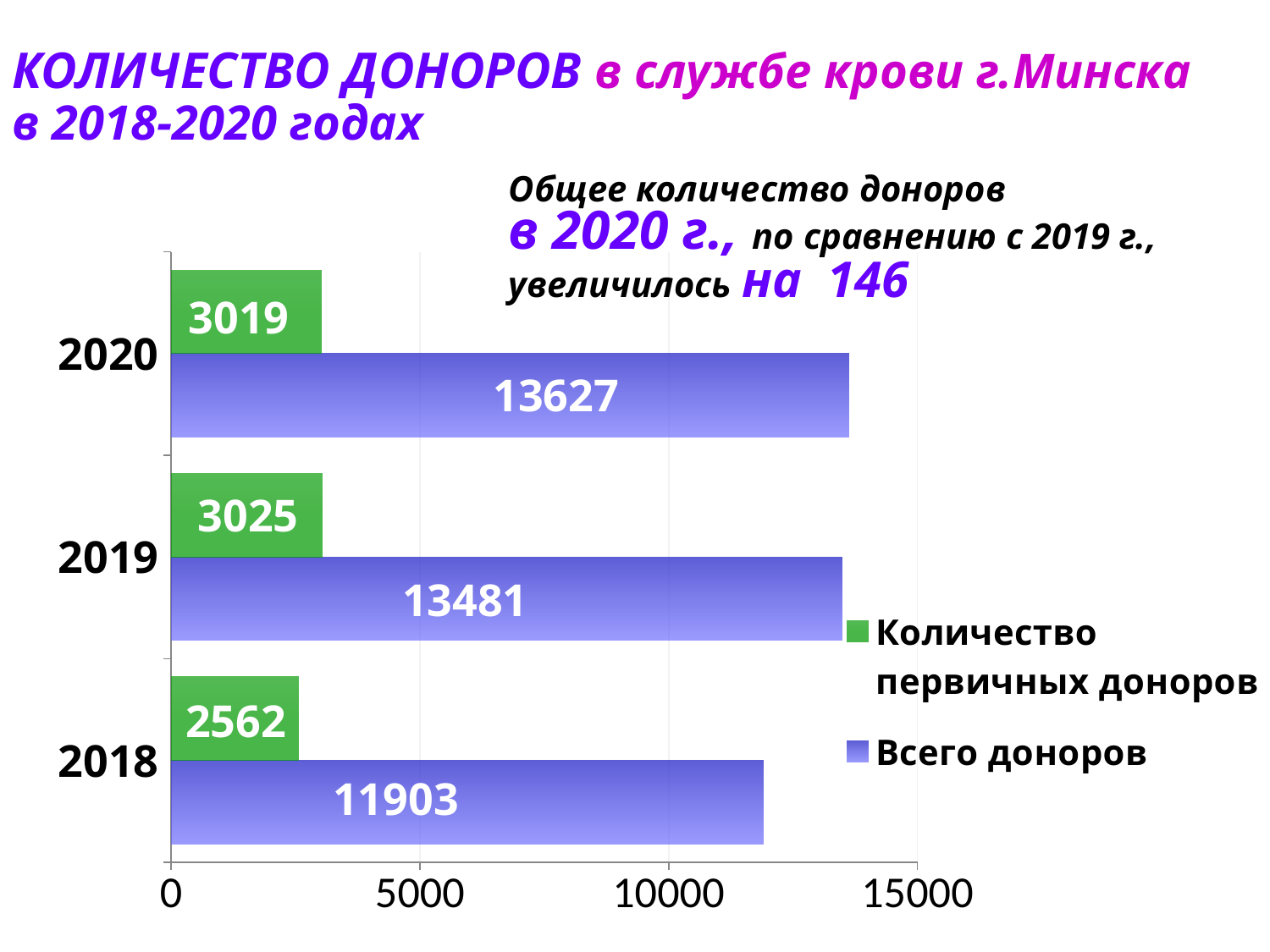
What is the difference between 'Всего доноров' in 2020 and in 2019? 146 Which year has the highest value for 'Всего доноров'? 2020 Is the value of 'Всего доноров' for 2018 greater or less than 10000? greater How many years are shown on the chart? 3 What is the value of 'Всего доноров' for 2019? 13481 What is the difference between 'Всего доноров' and 'Количество первичных доноров' in 2018? 9341 What is the value of 'Всего доноров' for 2020? 13627 How many series does the legend list? 2 What is the value of 'Количество первичных доноров' for 2018? 2562 What kind of chart is shown on the slide? bar chart What is the value of 'Количество первичных доноров' for 2019? 3025 Which year has the lowest value for 'Количество первичных доноров'? 2018